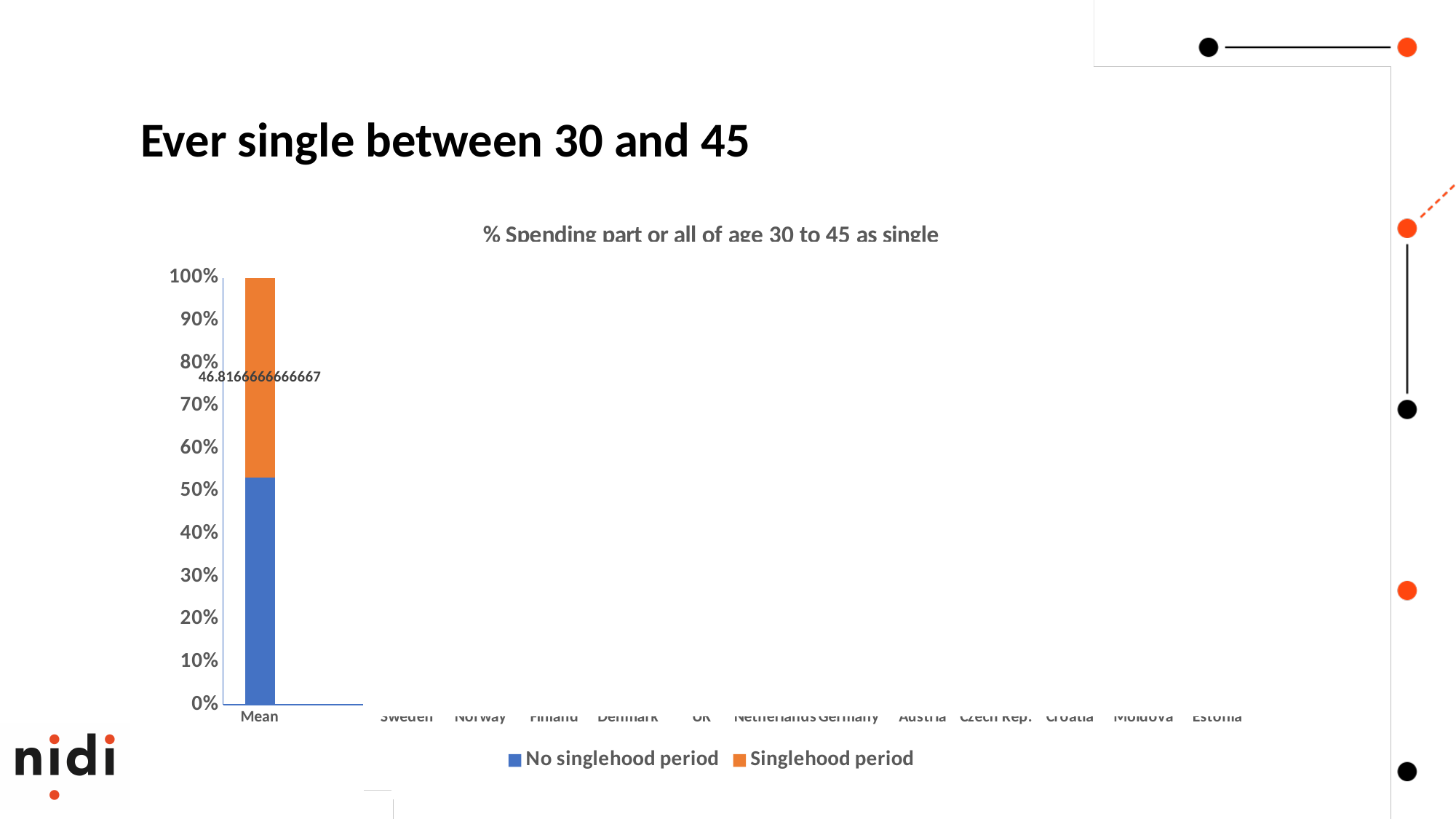
What value is printed on the Singlehood period segment of the Mean bar? 46.8166666666667 Is the No singlehood period value for Mean greater or less than 40%? greater What kind of chart is shown on the slide? bar chart What are the two series named in the chart legend? No singlehood period, Singlehood period For the Mean bar, which segment is larger: No singlehood period or Singlehood period? No singlehood period How many series does the chart legend list? 2 Is the Singlehood period value for Mean greater or less than 50%? less What is the title of the chart? % Spending part or all of age 30 to 45 as single What is the highest value shown on the y axis? 100% Is the No singlehood period value for Mean greater or less than 60%? less